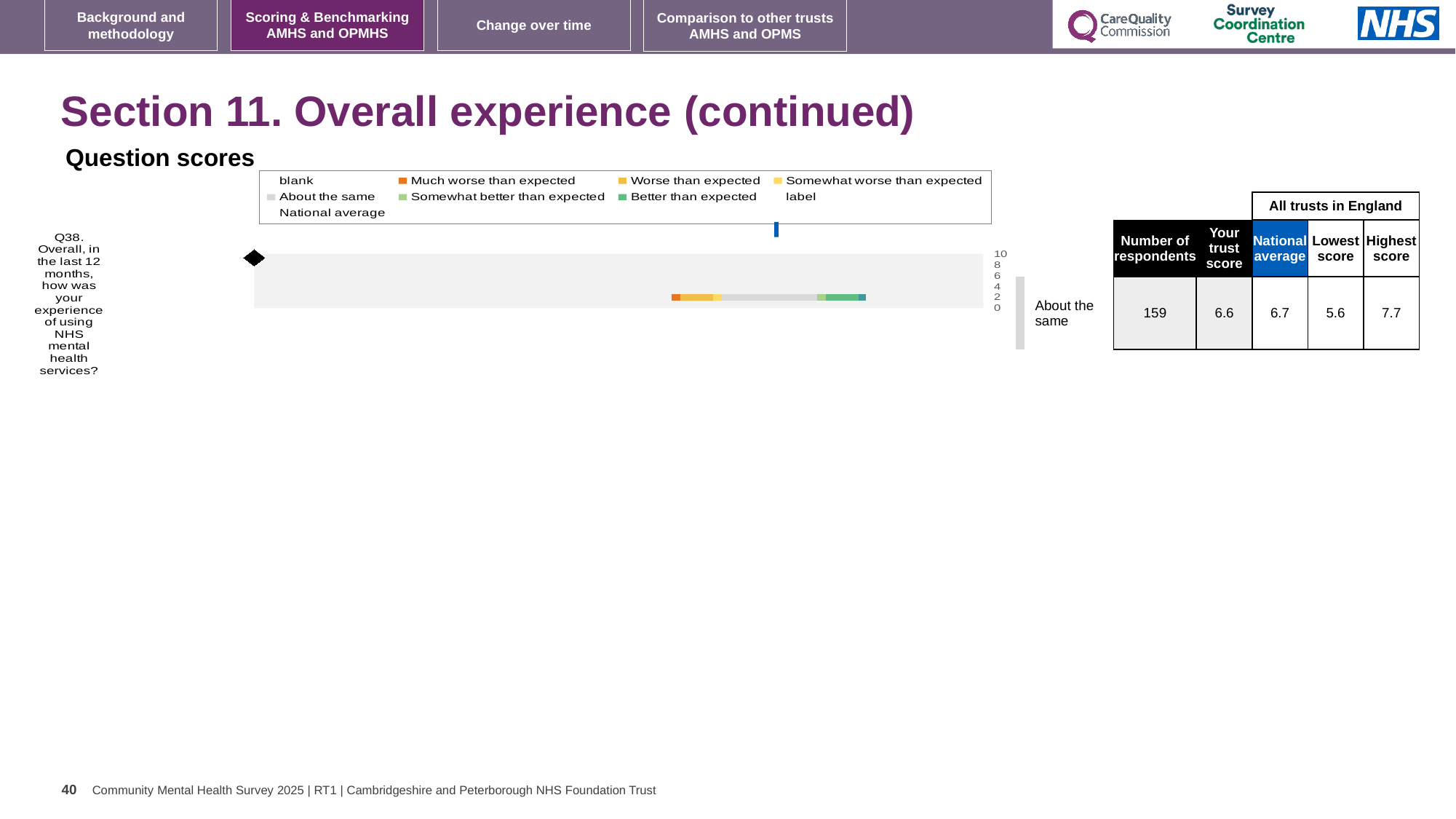
What benchmark category label is shown next to the bar for Q38? About the same What is the 'Your trust score' value for Q38 in the table beside the chart? 6.6 What kind of chart is shown under 'Question scores'? bar chart How many respondents are listed for Q38 in the table beside the chart? 159 For Q38, which is larger: the trust score or the national average? national average In the chart legend, what colour represents 'Much worse than expected'? orange Which question number is plotted in the Question scores chart? Q38 What is the highest score among all trusts in England for Q38? 7.7 How many survey questions are plotted in the Question scores chart? 1 What is the lowest score among all trusts in England for Q38? 5.6 For Q38, what is the difference between the highest score and the lowest score among all trusts in England? 2.1 What is the national average score for Q38 in the table beside the chart? 6.7